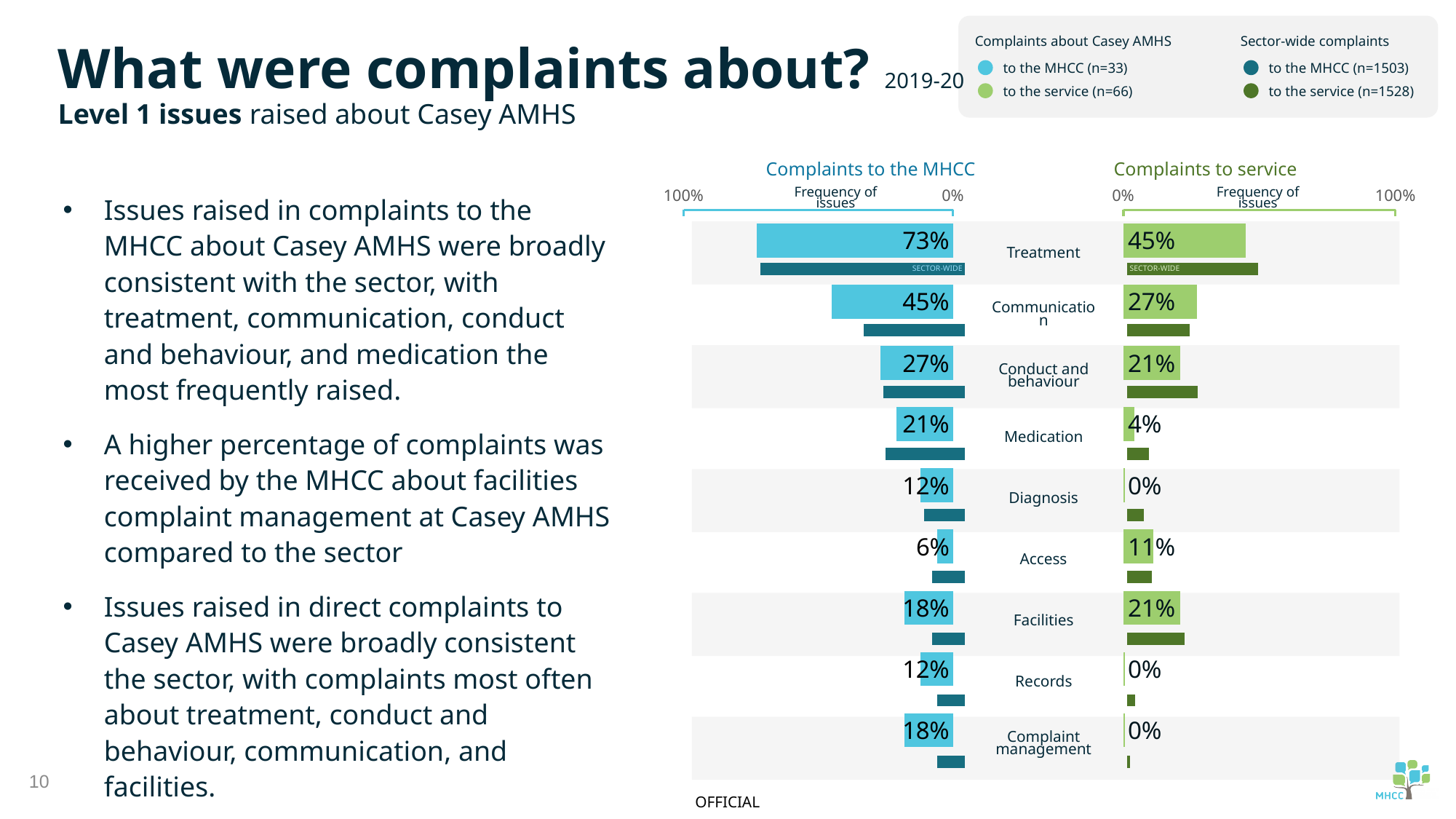
What type of chart is used to show the frequency of issues? Bar chart In the 'Complaints to service' chart, what is the value for Communication? 27% How many issue categories are listed in the charts? 9 In the 'Complaints to service' chart, what is the value for Medication? 4% In the 'Complaints to the MHCC' chart, what percentage of complaints raised Treatment as an issue? 73% In the 'Complaints to service' chart, what is the difference between the values for Treatment and Conduct and behaviour? 24% In the 'Complaints to the MHCC' chart, what is the difference between the values for Treatment and Communication? 28% In the 'Complaints to service' chart, which is larger, the value for Facilities or the value for Access? Facilities In the 'Complaints to the MHCC' chart, which issue has the highest frequency? Treatment In the 'Complaints to the MHCC' chart, which issue has the lowest frequency? Access According to the legend, how many complaints about Casey AMHS were made to the MHCC (n)? n=33 In the 'Complaints to the MHCC' chart, what is the value for Complaint management? 18%